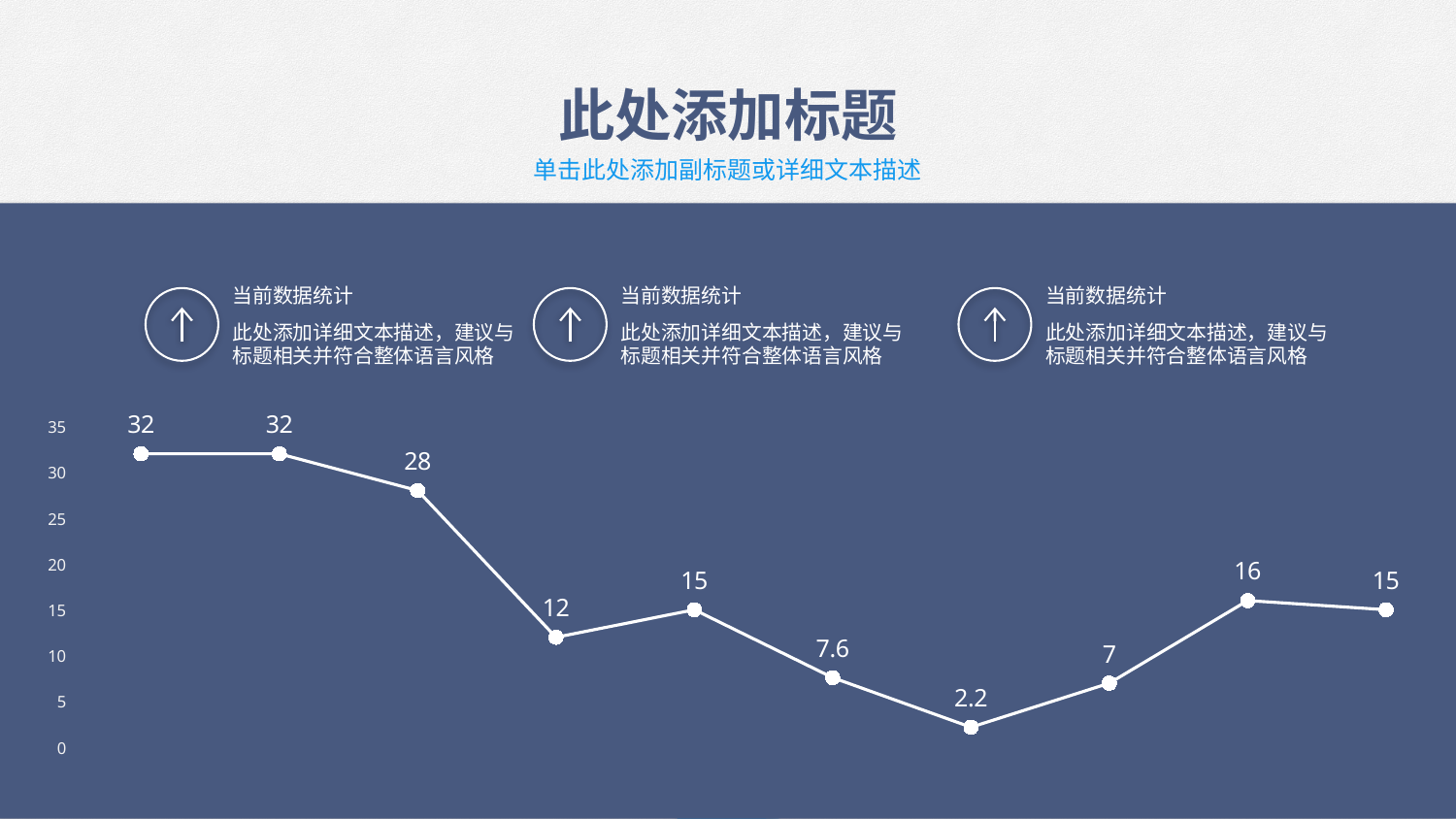
What is the value of the first data point on the line chart? 32 How many data points are plotted on the line chart? 10 What is the maximum value shown on the vertical axis of the line chart? 35 What is the difference between the third data point (28) and the fourth data point (12)? 16 What is the value of the third data point on the line chart? 28 What is the value of the sixth data point on the line chart? 7.6 What kind of chart is shown on the slide? line chart What is the value of the seventh data point on the line chart? 2.2 What is the highest value plotted on the line chart? 32 Do the values generally rise or fall from the first data point to the seventh data point? fall Which is larger, the ninth data point or the tenth data point? the ninth data point (16) What is the lowest value plotted on the line chart? 2.2